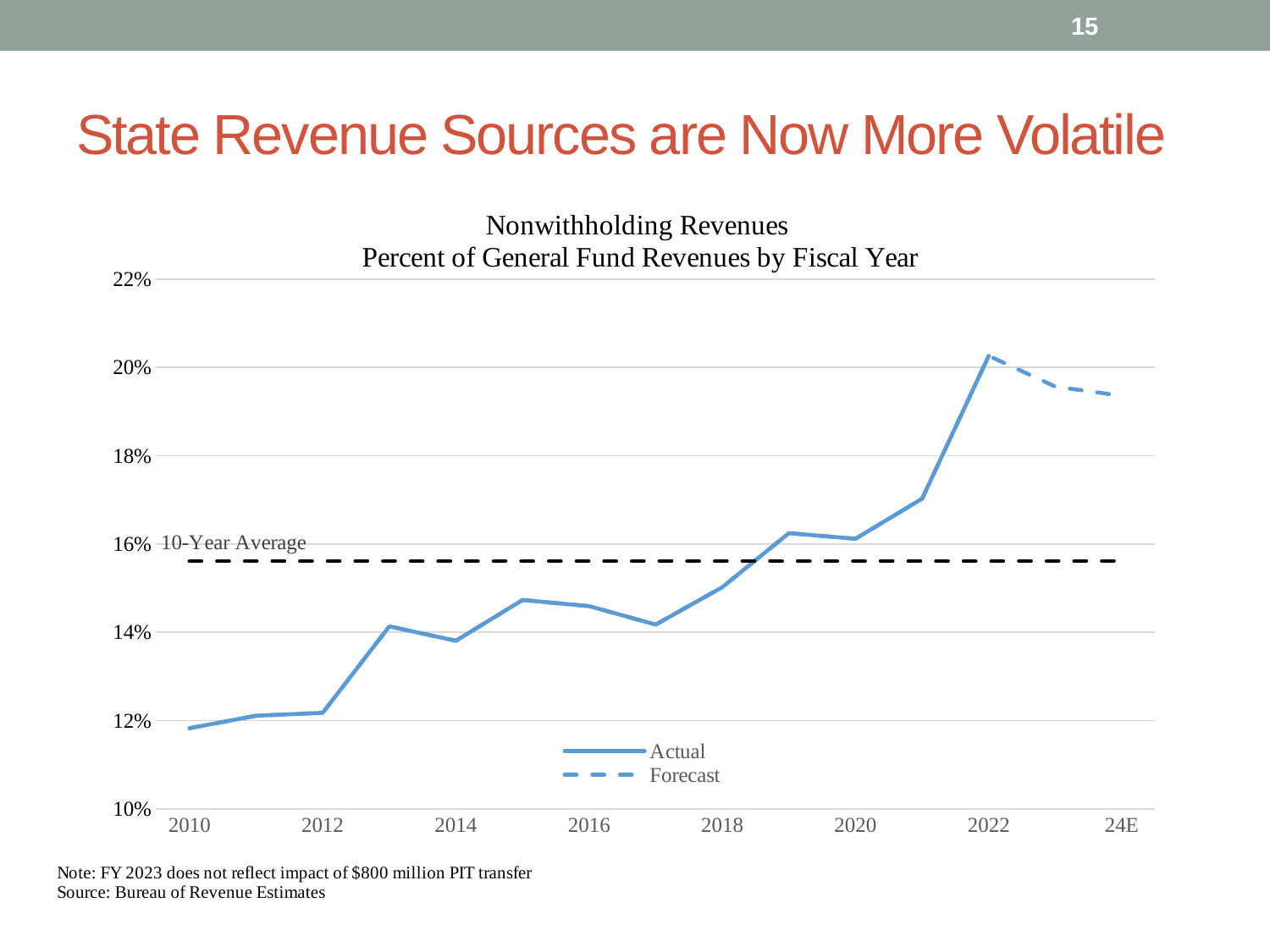
Which is larger, the value for 2022 or the value for 2010? 2022 What are the two series named in the legend? Actual and Forecast What kind of chart is shown on the slide? line chart Is the value for 2014 greater or less than 14%? less Which fiscal year has the lowest nonwithholding revenue share? 2010 What is the title of the chart? Nonwithholding Revenues Percent of General Fund Revenues by Fiscal Year Which fiscal year has the highest nonwithholding revenue share? 2022 Is the value for 2022 greater or less than 20%? greater Overall, do the values rise or fall from 2010 to 2022? rise Is the value for 2019 greater or less than 16%? greater How many series does the legend list? 2